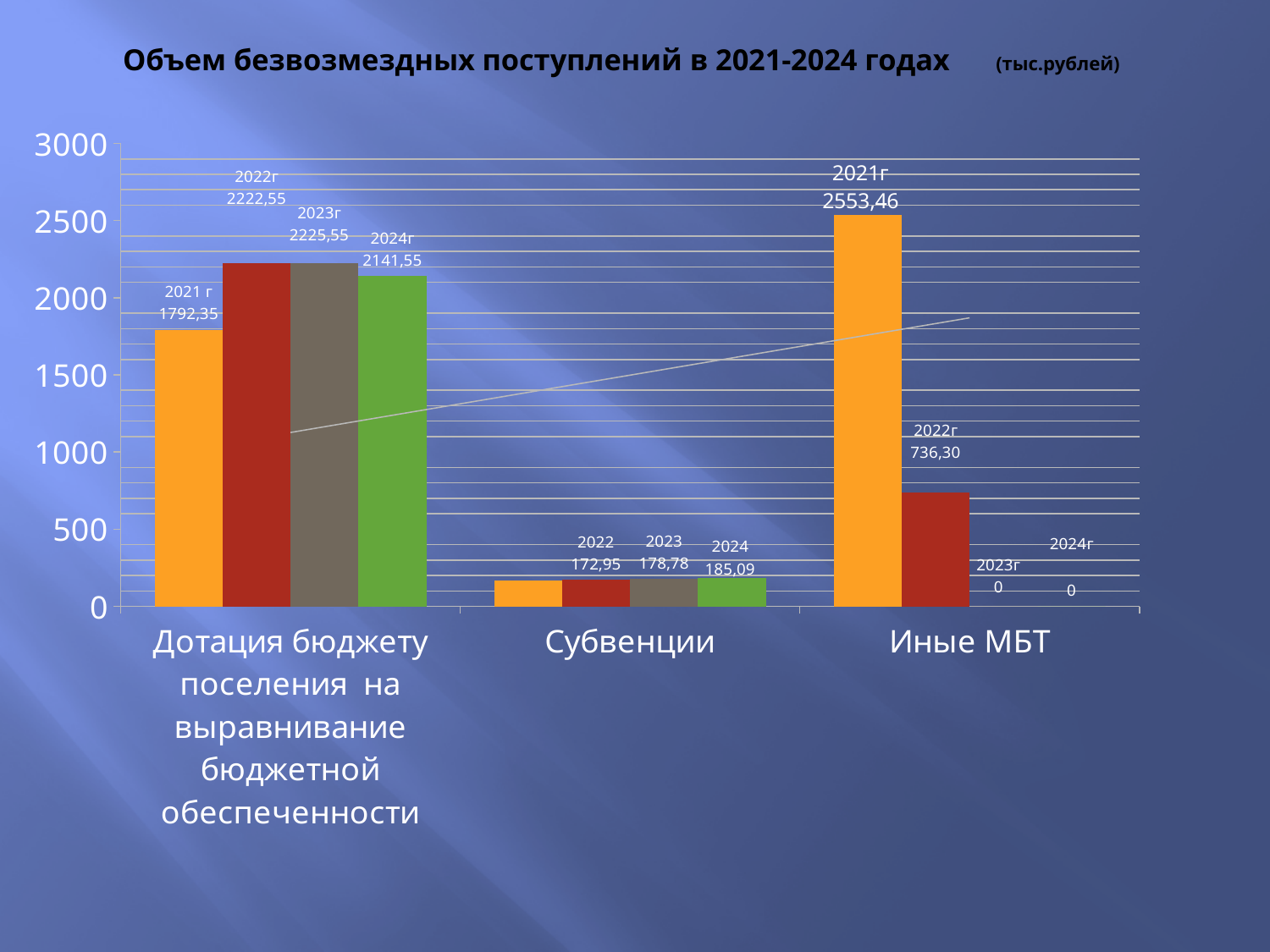
What is the title of the chart? Объем безвозмездных поступлений в 2021-2024 годах How many categories are shown on the x axis? 3 What is the difference between the 2021 and 2022 values in the category "Иные МБТ"? 1817,16 What is the value for 2023 in the category "Иные МБТ"? 0 Which year has the highest value in the category "Иные МБТ"? 2021 What type of chart is shown on the slide? bar chart What is the value for 2021 in the category "Иные МБТ"? 2553,46 Which is larger: the 2024 value for "Дотация бюджету поселения на выравнивание бюджетной обеспеченности" or the 2021 value for "Иные МБТ"? 2021 value for Иные МБТ What is the value for 2022 in the category "Дотация бюджету поселения на выравнивание бюджетной обеспеченности"? 2222,55 Is the 2021 value for "Субвенции" greater or less than 500? less Which year has the lowest value in the category "Дотация бюджету поселения на выравнивание бюджетной обеспеченности"? 2021 What is the value for 2024 in the category "Субвенции"? 185,09